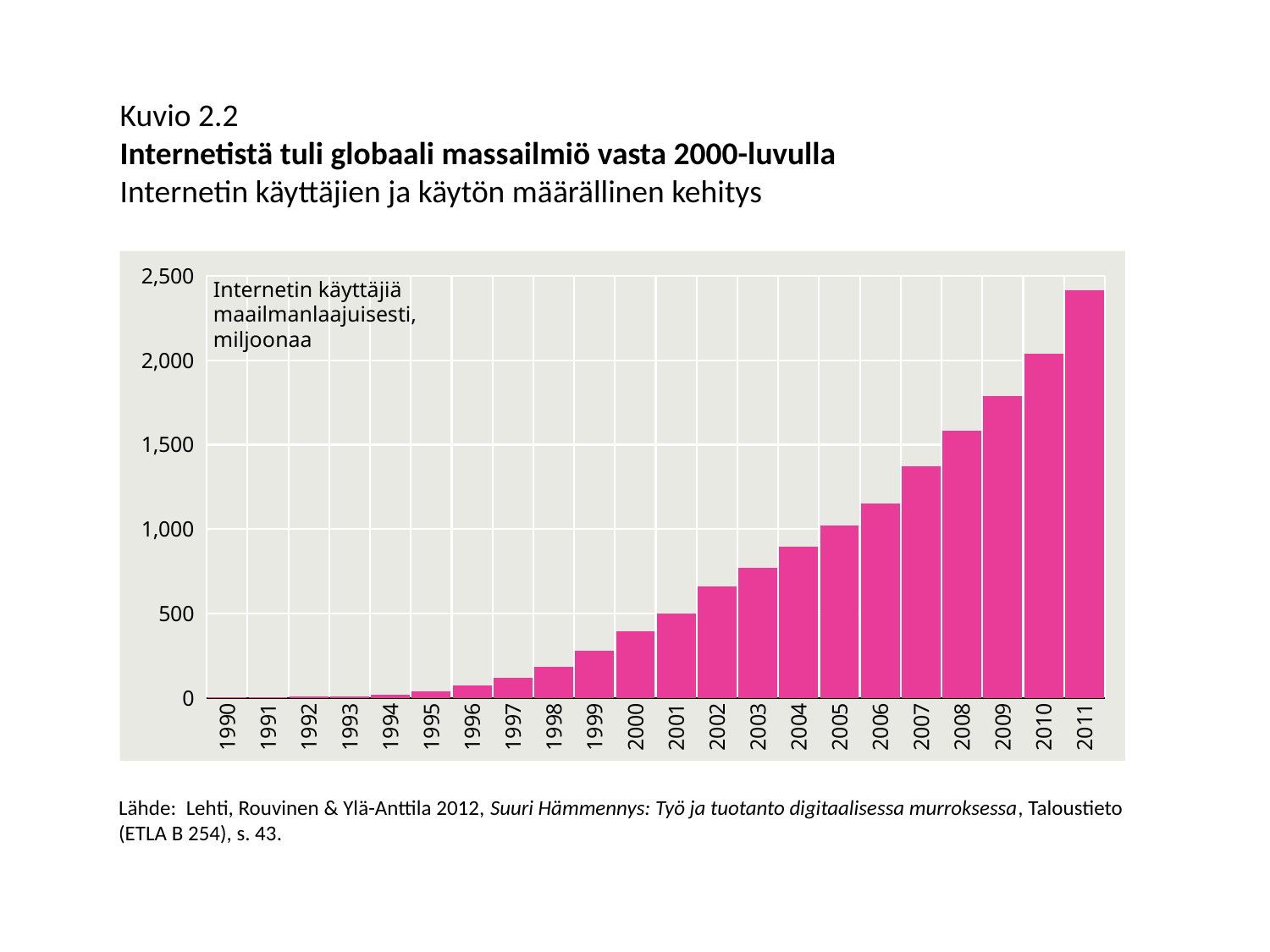
Do the values in the chart rise or fall from 1990 to 2011? rise Is the value for 2009 greater or less than 2,000? less Is the value for 2002 greater or less than 500? greater Which year has the highest number of internet users in the chart? 2011 What kind of chart is shown on the slide? bar chart Is the value for 1999 greater or less than 500? less What is the bold title of the figure (Kuvio 2.2) on the slide? Internetistä tuli globaali massailmiö vasta 2000-luvulla How many years are plotted on the x axis of the chart? 22 Which year has the larger value, 2003 or 2008? 2008